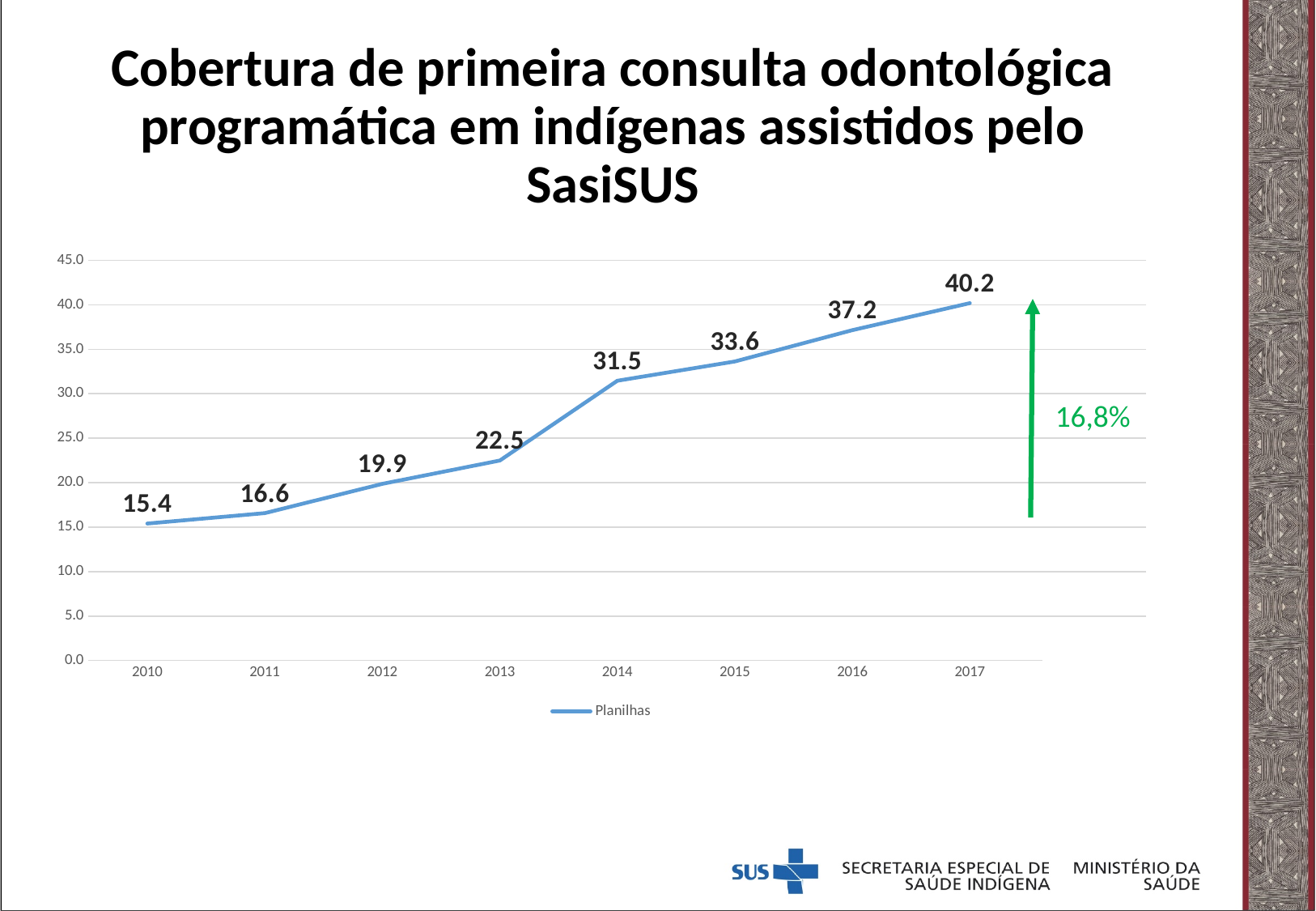
What is the difference between the values for 2014 and 2013? 9.0 What kind of chart is shown? line chart How many years are plotted on the chart? 8 What is the value for 2010? 15.4 What is the value for 2017? 40.2 Which year has the lowest value? 2010 Which year has the highest value? 2017 Do the values rise or fall from 2010 to 2017? rise Is the value for 2016 greater or less than 35.0? greater Which is larger, the value for 2015 or the value for 2012? 2015 What is the difference between the values for 2017 and 2010? 24.8 What is the value for 2014? 31.5